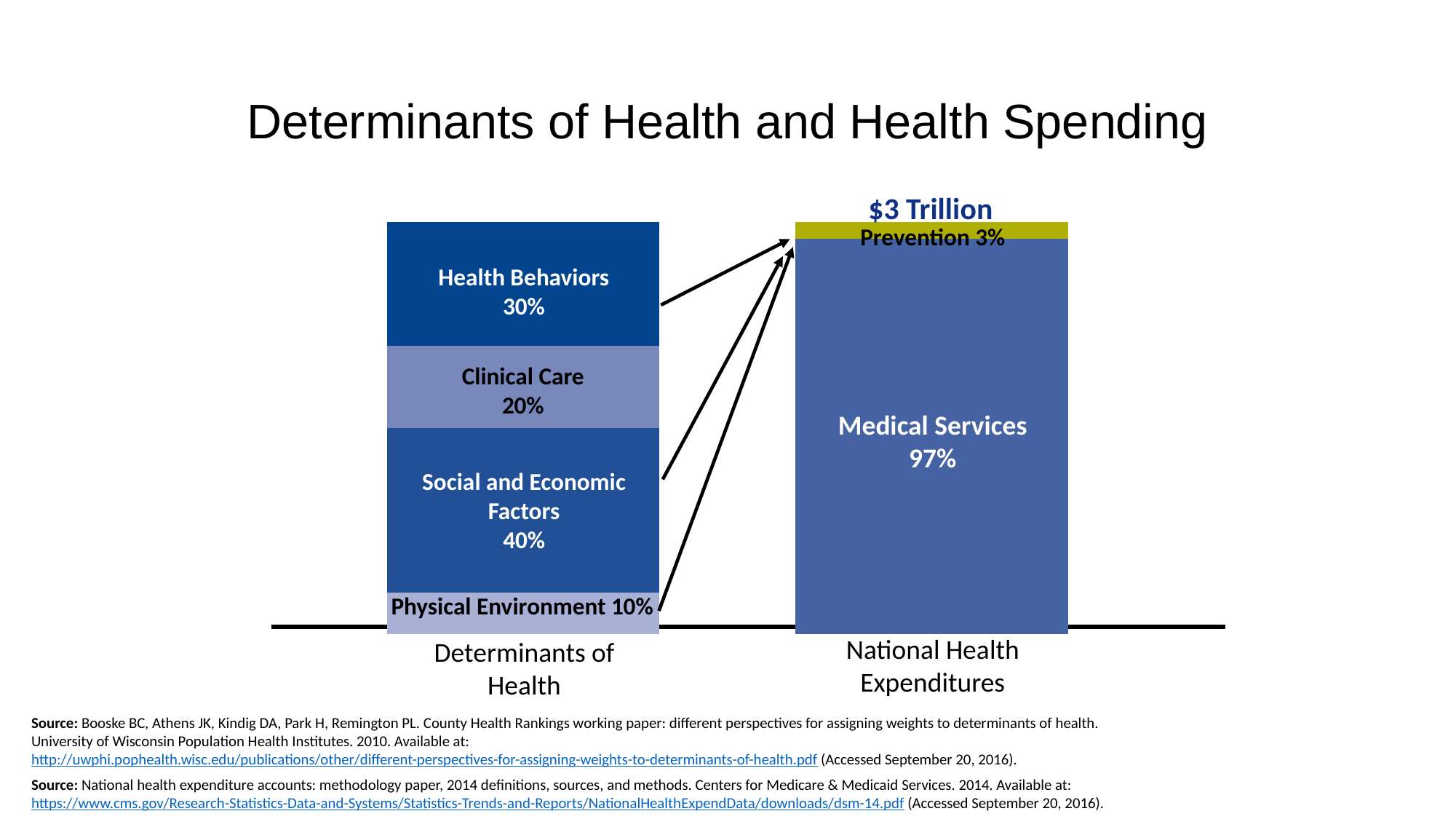
In the National Health Expenditures bar, what is the difference between the Medical Services share and the Prevention share? 94% In the Determinants of Health bar, what is the difference between the Social and Economic Factors share and the Clinical Care share? 20% How many segments make up the Determinants of Health bar? 4 In the National Health Expenditures bar, what percentage goes to Medical Services? 97% Which segment of the Determinants of Health bar is the smallest? Physical Environment In the Determinants of Health bar, which is larger: Health Behaviors or Clinical Care? Health Behaviors In the Determinants of Health bar, what percentage is attributed to Social and Economic Factors? 40% In the National Health Expenditures bar, what percentage goes to Prevention? 3% In the Determinants of Health bar, what percentage is attributed to Clinical Care? 20% In the Determinants of Health bar, what percentage is attributed to Health Behaviors? 30% Which segment of the Determinants of Health bar is the largest? Social and Economic Factors What total dollar amount is shown above the National Health Expenditures bar? $3 Trillion